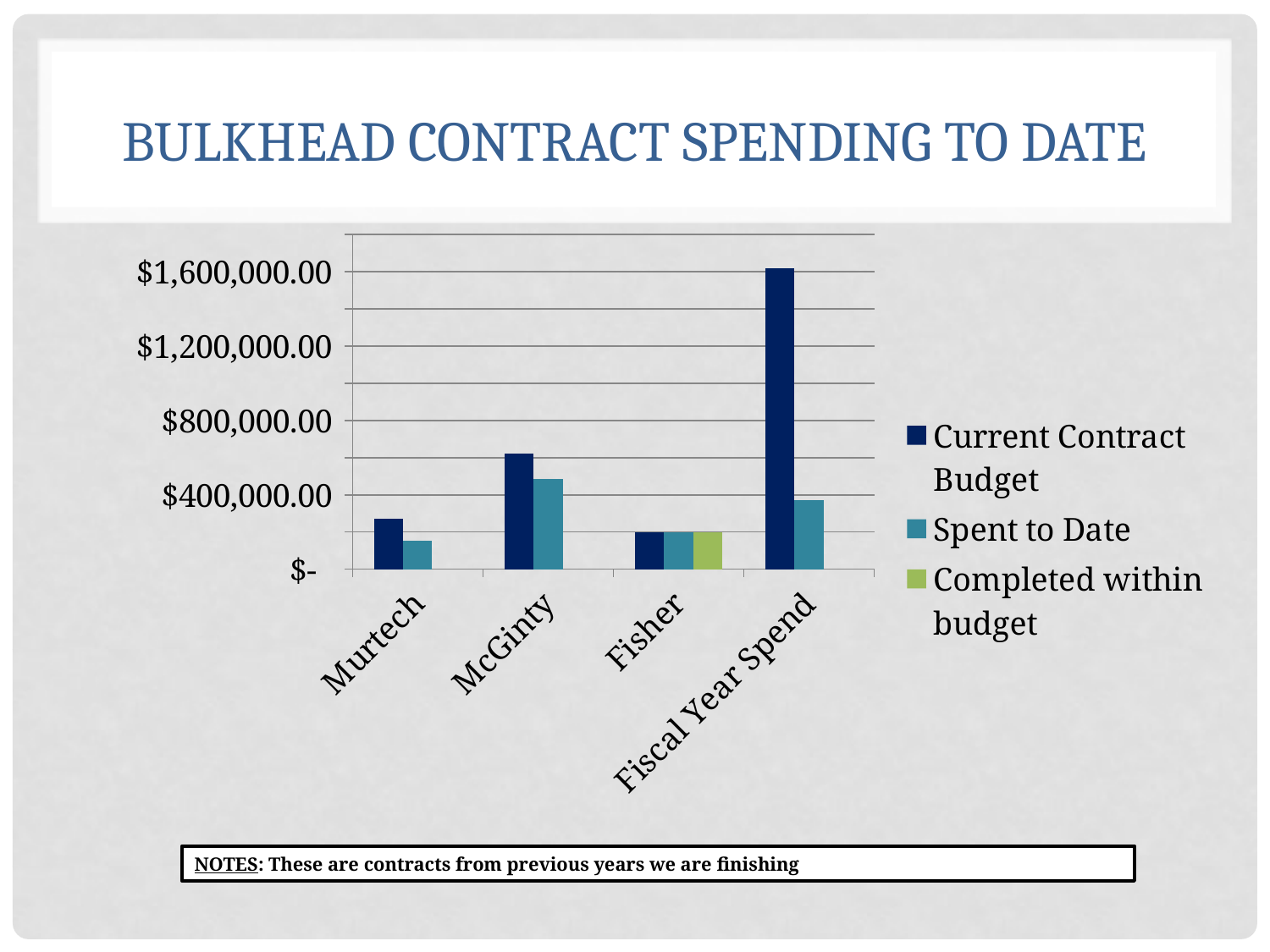
How many series does the legend list? 3 Which category has the highest Spent to Date value? McGinty What kind of chart is shown on the slide? bar chart What is the title of the slide's chart? BULKHEAD CONTRACT SPENDING TO DATE Which category is the only one with a visible Completed within budget bar? Fisher Is the Current Contract Budget for Murtech greater or less than $400,000.00? less How many categories are shown on the x axis? 4 Is the Current Contract Budget for Fiscal Year Spend greater or less than $1,200,000.00? greater Which category has the highest Current Contract Budget? Fiscal Year Spend Which has the larger Current Contract Budget, Murtech or McGinty? McGinty Is the Current Contract Budget for McGinty greater or less than $800,000.00? less